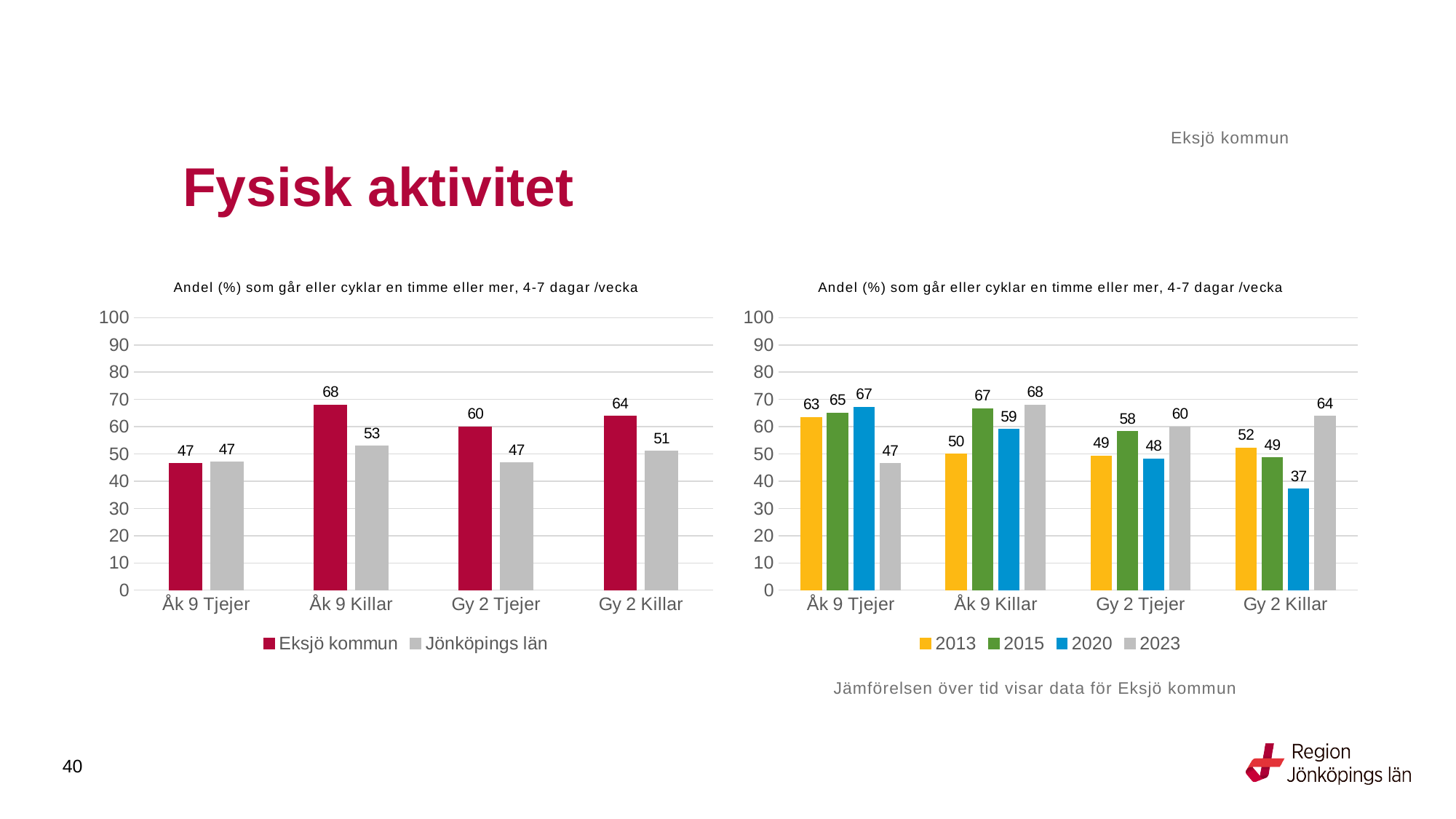
In the right chart, how many series does the legend list? 4 In the left chart, which category has the lowest value for Jönköpings län? Åk 9 Tjejer and Gy 2 Tjejer (both 47) In the right chart, what is the difference between the 2013 and 2023 values for Åk 9 Tjejer? 16 In the left chart, what is the value for Jönköpings län for Gy 2 Killar? 51 In the right chart, what is the value for 2020 for Gy 2 Killar? 37 In the left chart, what is the difference between Eksjö kommun and Jönköpings län for Åk 9 Killar? 15 In the left chart, which is larger for Gy 2 Tjejer: Eksjö kommun or Jönköpings län? Eksjö kommun In the right chart, how do the values for Gy 2 Killar change from 2013 to 2020? They fall In the right chart, which year has the highest value for Åk 9 Killar? 2023 What type of chart is the right chart? Bar chart In the left chart, what is the value for Eksjö kommun for Åk 9 Killar? 68 How many series does the legend of the left chart list? 2